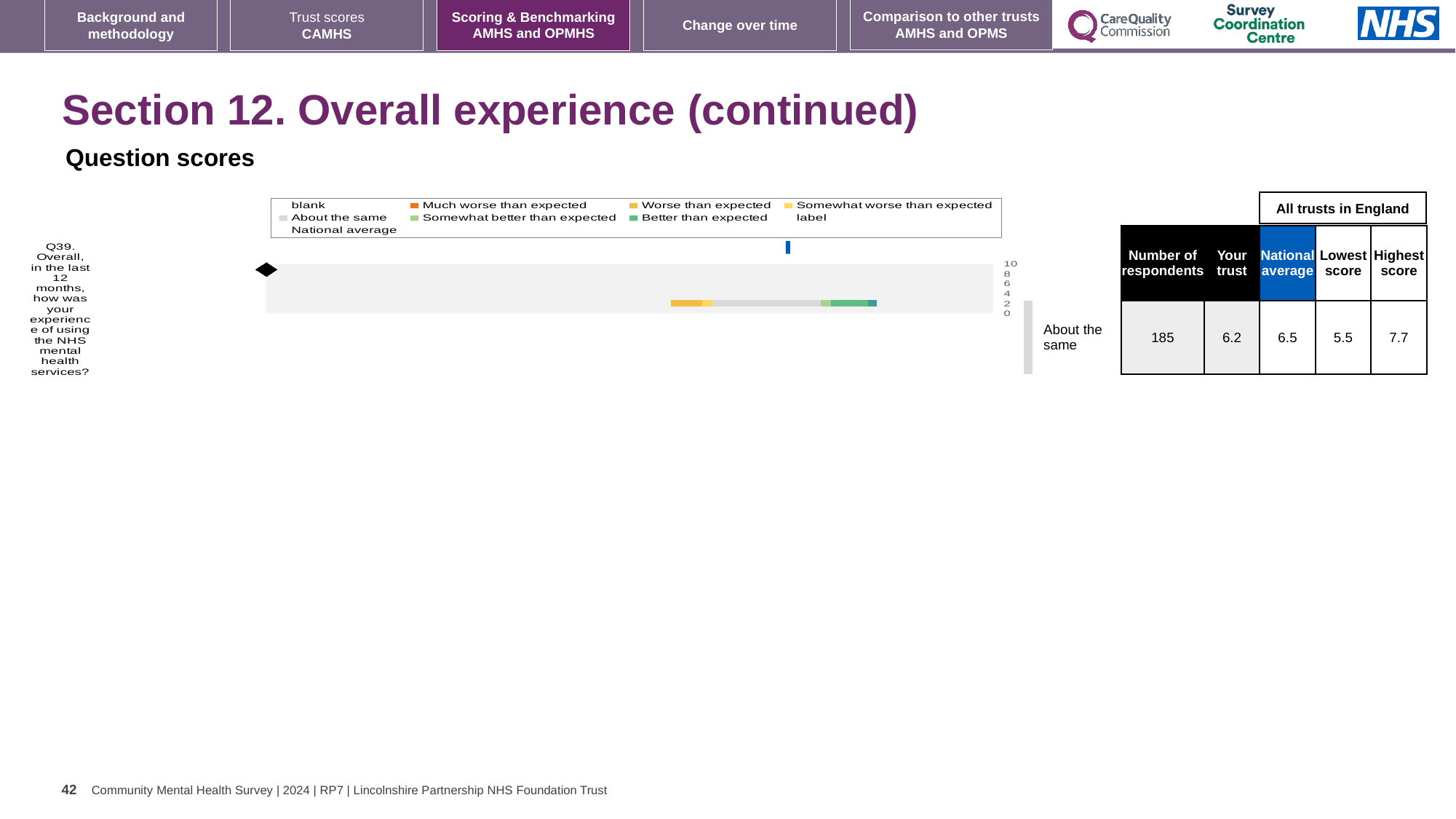
Which is larger for Q39, the trust's score or the national average? National average What kind of chart is used to show the Q39 question score? bar chart What is the lowest score among all trusts in England for Q39? 5.5 What colour represents 'Better than expected' in the chart legend? green How many respondents answered Q39? 185 What is the national average score for Q39? 6.5 Which benchmark category is the trust's Q39 score placed in? About the same How many questions are plotted in the question scores chart? 1 What is the highest score among all trusts in England for Q39? 7.7 What is the 'Your trust' score for Q39 (overall experience of using NHS mental health services)? 6.2 What is the difference between the highest and lowest trust scores for Q39? 2.2 By how much does the national average exceed the trust's score for Q39? 0.3